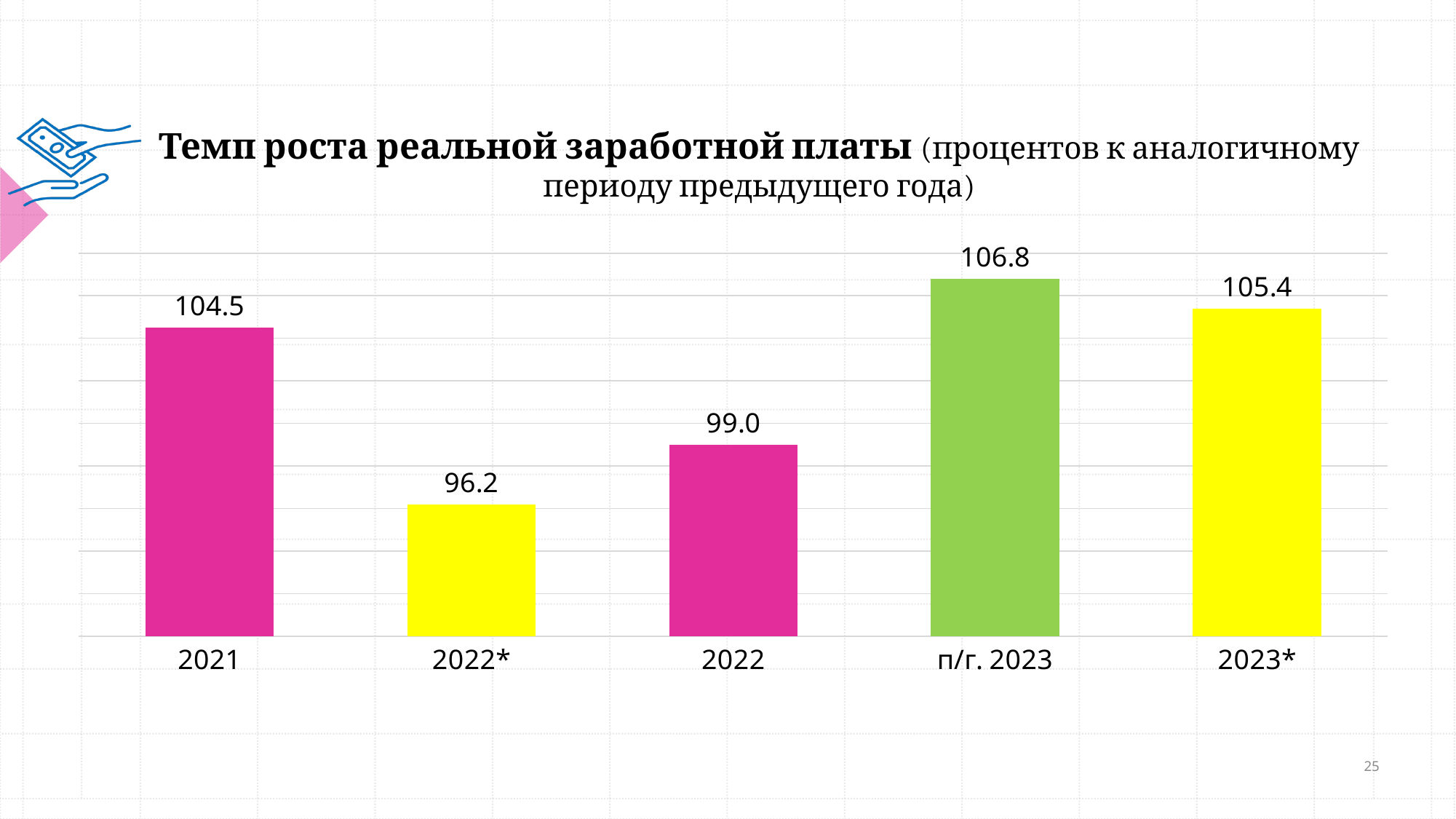
How many bars are shown in the chart? 5 What is the value for 2022? 99.0 Which category has the highest value? п/г. 2023 What is the value for п/г. 2023? 106.8 What kind of chart is shown on the slide? Bar chart What is the difference between the values for п/г. 2023 and 2022*? 10.6 Which category has the lowest value? 2022* What colour is the bar for п/г. 2023? Green What is the value for 2023*? 105.4 What is the value for 2022*? 96.2 What is the value for 2021? 104.5 Which is larger, the value for 2021 or the value for 2022? 2021